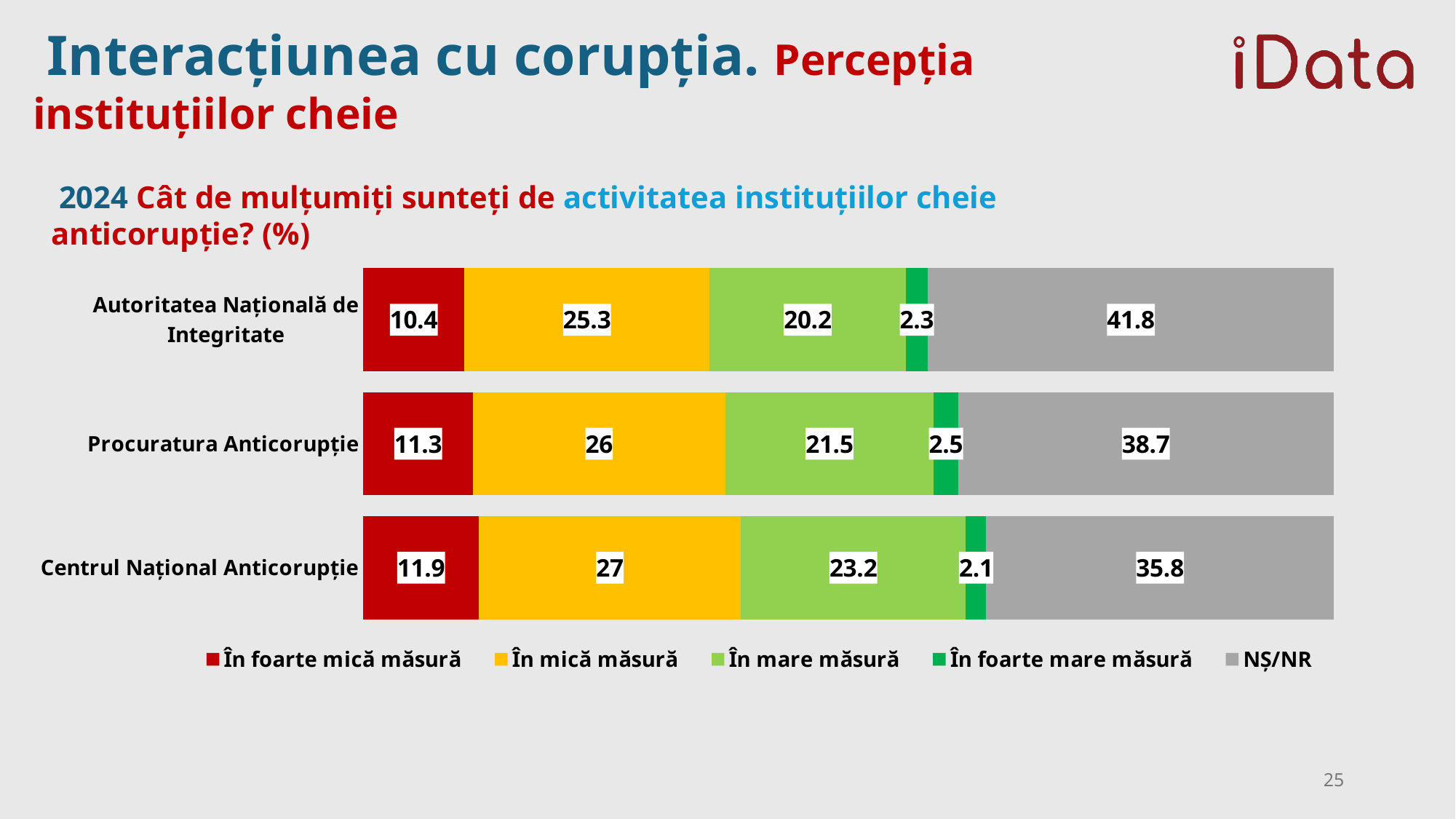
What is the "NȘ/NR" value for Autoritatea Națională de Integritate? 41.8 Which institution has the lowest "NȘ/NR" value? Centrul Național Anticorupție What is the value for "În mică măsură" for Procuratura Anticorupție? 26 How many series does the legend list? 5 Which legend entry is shown in grey? NȘ/NR What is the total of the stacked bar for Procuratura Anticorupție? 100 What kind of chart is shown on the slide? Stacked bar chart What is the value for "În foarte mare măsură" for Centrul Național Anticorupție? 2.1 What is the difference between the "NȘ/NR" values for Autoritatea Națională de Integritate and Centrul Național Anticorupție? 6 How many institutions are shown in the chart? 3 Which is larger: the "În foarte mică măsură" value for Procuratura Anticorupție or for Autoritatea Națională de Integritate? Procuratura Anticorupție Which institution has the highest "În mare măsură" value? Centrul Național Anticorupție